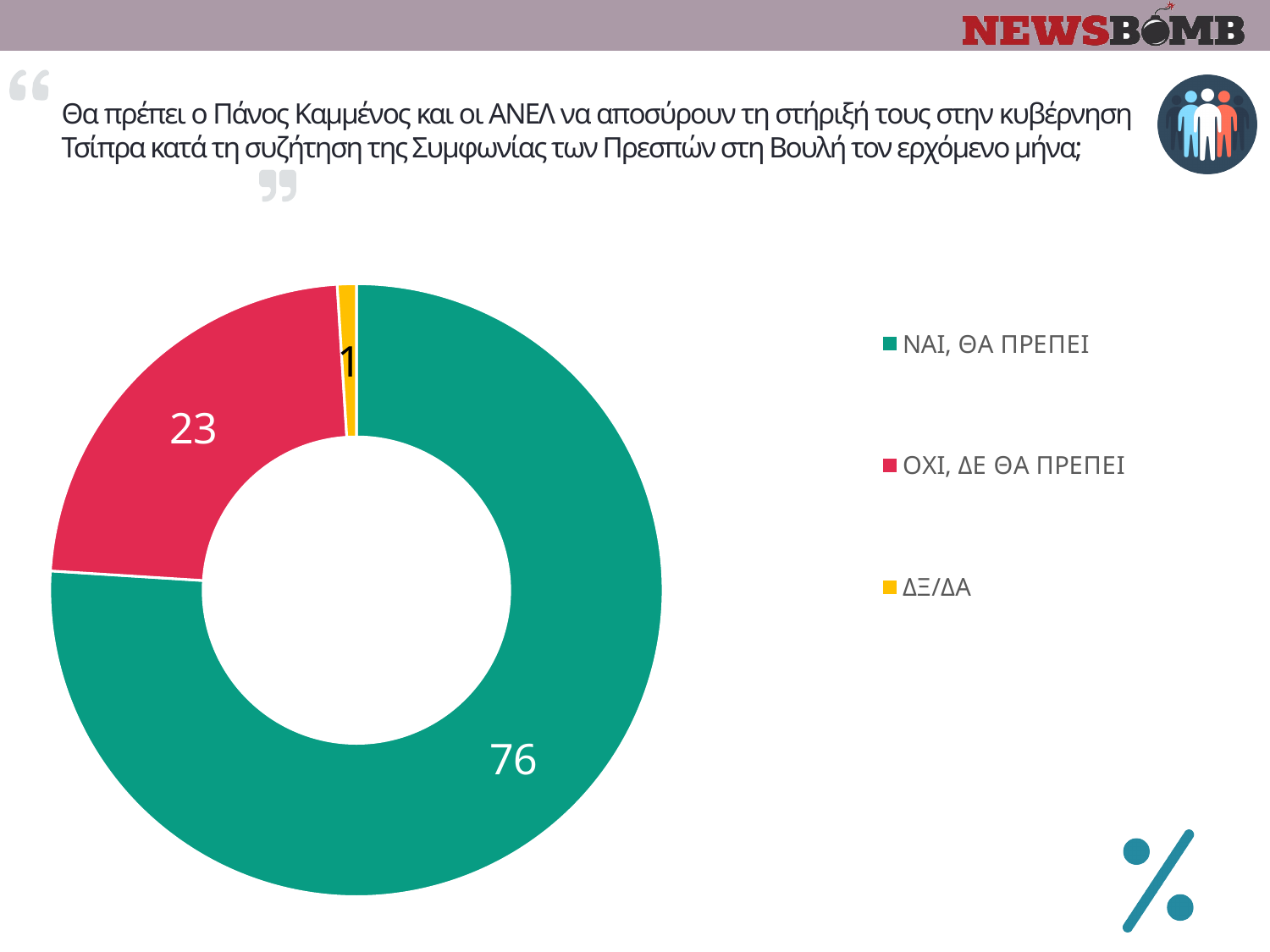
What value is shown for the 'ΝΑΙ, ΘΑ ΠΡΕΠΕΙ' slice? 76 What is the difference between the values for 'ΝΑΙ, ΘΑ ΠΡΕΠΕΙ' and 'ΟΧΙ, ΔΕ ΘΑ ΠΡΕΠΕΙ'? 53 What value is shown for the 'ΟΧΙ, ΔΕ ΘΑ ΠΡΕΠΕΙ' slice? 23 What is the total of the three values shown on the chart? 100 Which is larger, the value for 'ΟΧΙ, ΔΕ ΘΑ ΠΡΕΠΕΙ' or the value for 'ΔΞ/ΔΑ'? ΟΧΙ, ΔΕ ΘΑ ΠΡΕΠΕΙ How many categories does the chart show? 3 Which legend entry is shown in yellow? ΔΞ/ΔΑ Which category has the smallest slice? ΔΞ/ΔΑ What kind of chart is shown on the slide? Pie chart (doughnut) What colour is the 'ΟΧΙ, ΔΕ ΘΑ ΠΡΕΠΕΙ' slice? Red Which category has the largest slice? ΝΑΙ, ΘΑ ΠΡΕΠΕΙ What value is shown for the 'ΔΞ/ΔΑ' slice? 1